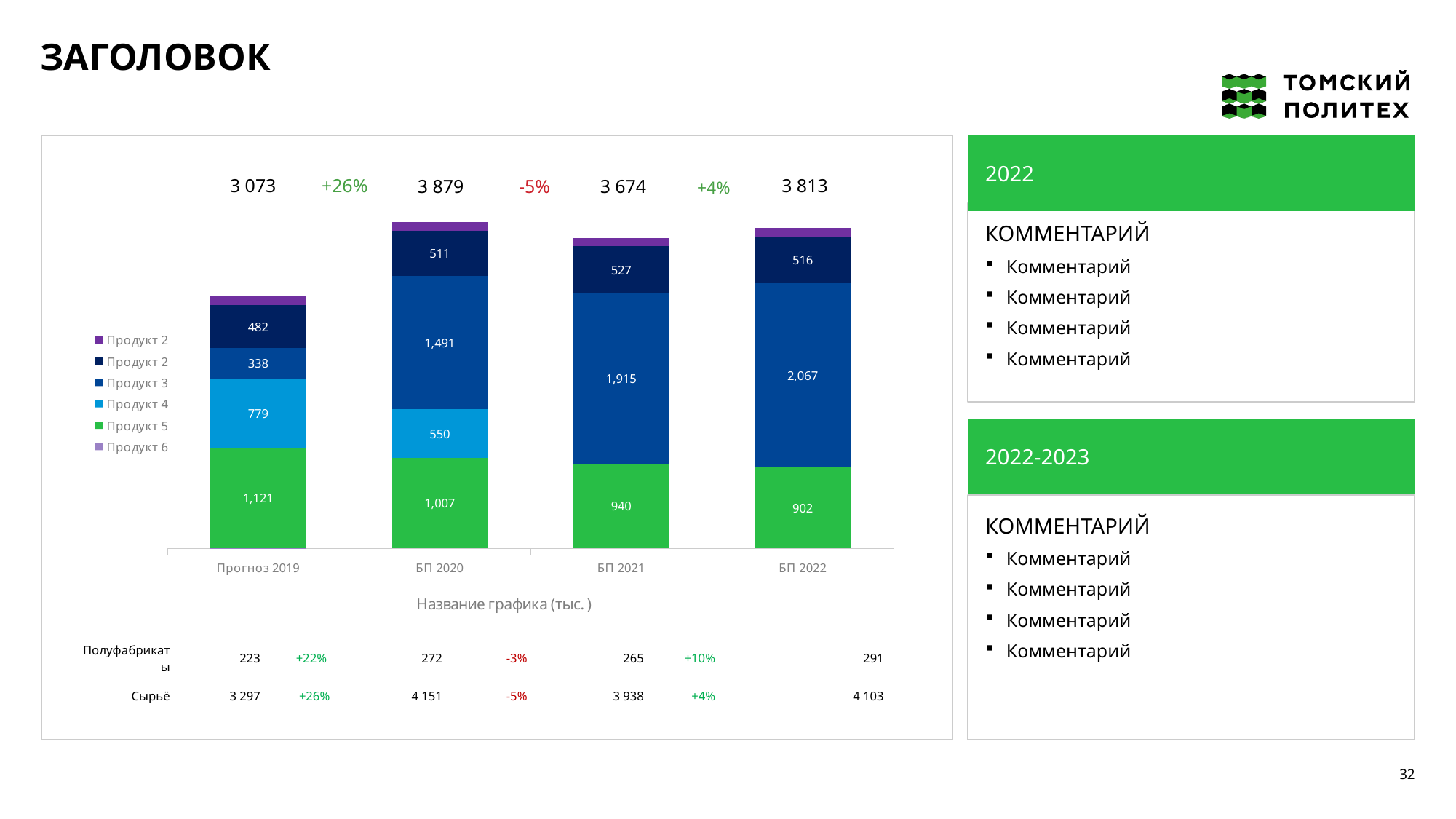
What is the value of Продукт 4 for БП 2020? 550 What is the value of Продукт 5 for Прогноз 2019? 1,121 Which category has the lowest total? Прогноз 2019 How many categories are shown on the x axis? 4 Do the Продукт 5 values rise or fall from Прогноз 2019 to БП 2022? Fall Which is larger: the Продукт 3 value for БП 2021 or for БП 2022? БП 2022 What is the value of Продукт 3 for БП 2022? 2,067 What is the difference between the Продукт 5 values for Прогноз 2019 and БП 2022? 219 What kind of chart is shown? Stacked bar chart What is the total shown above the stacked bar for БП 2020? 3 879 How many series does the legend list? 6 Which category has the highest total? БП 2020